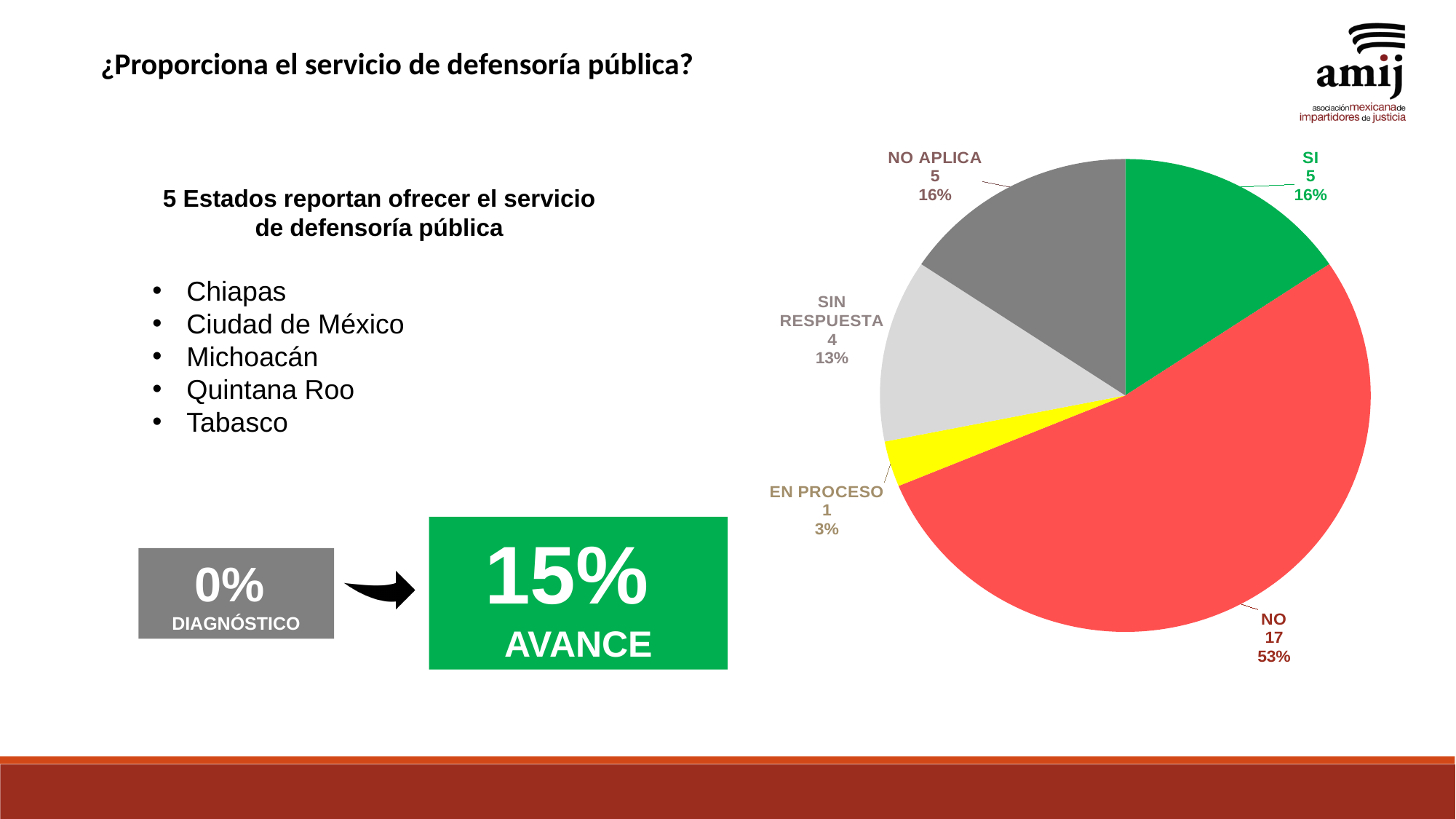
What percentage share does the NO slice have? 53% What percentage share does the SIN RESPUESTA slice have? 13% What is the count for the SI slice? 5 Which category has the largest slice? NO Which is larger, the SIN RESPUESTA count or the NO APLICA count? NO APLICA What kind of chart is shown on the slide? Pie chart What colour is the NO slice? Red How many slices does the pie chart have? 5 What is the count for the NO slice? 17 What is the difference between the NO count and the SI count? 12 Which category has the smallest slice? EN PROCESO What is the count for the EN PROCESO slice? 1